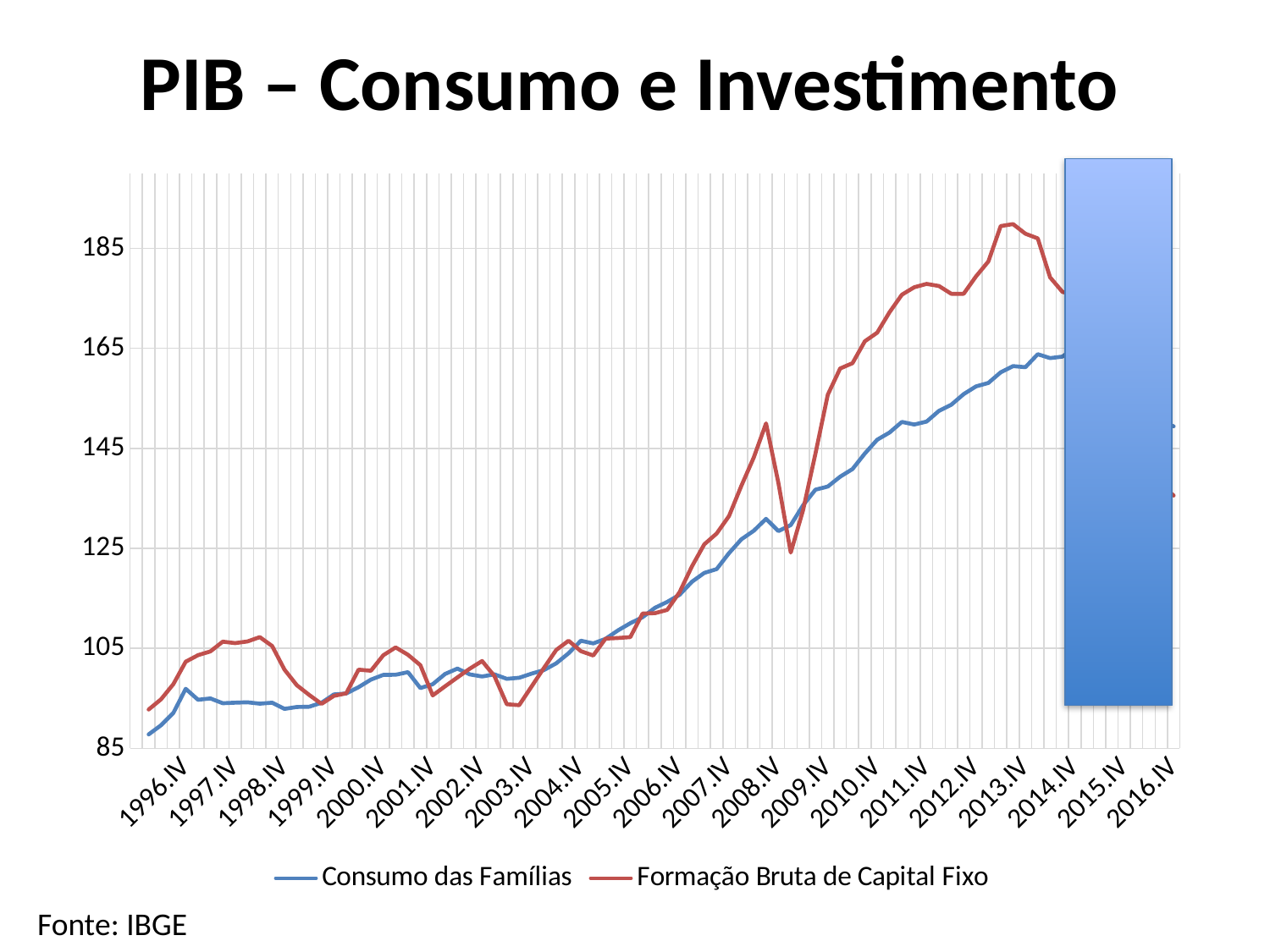
What are the two series named in the legend? Consumo das Famílias and Formação Bruta de Capital Fixo Is the value of Consumo das Famílias at 1996.IV greater or less than 105? less Is the value of Formação Bruta de Capital Fixo at 2014.IV greater or less than 165? greater Does Consumo das Famílias generally rise or fall from 2004.IV to 2014.IV? rise What is the title of the slide above the chart? PIB – Consumo e Investimento How many year labels are shown along the x axis? 21 Is the value of Formação Bruta de Capital Fixo at 2003.IV greater or less than 105? less At 2014.IV, which series has the higher value, Consumo das Famílias or Formação Bruta de Capital Fixo? Formação Bruta de Capital Fixo Which series reaches the highest value anywhere on the chart? Formação Bruta de Capital Fixo What kind of chart is shown on the slide? line chart How many series does the legend list? 2